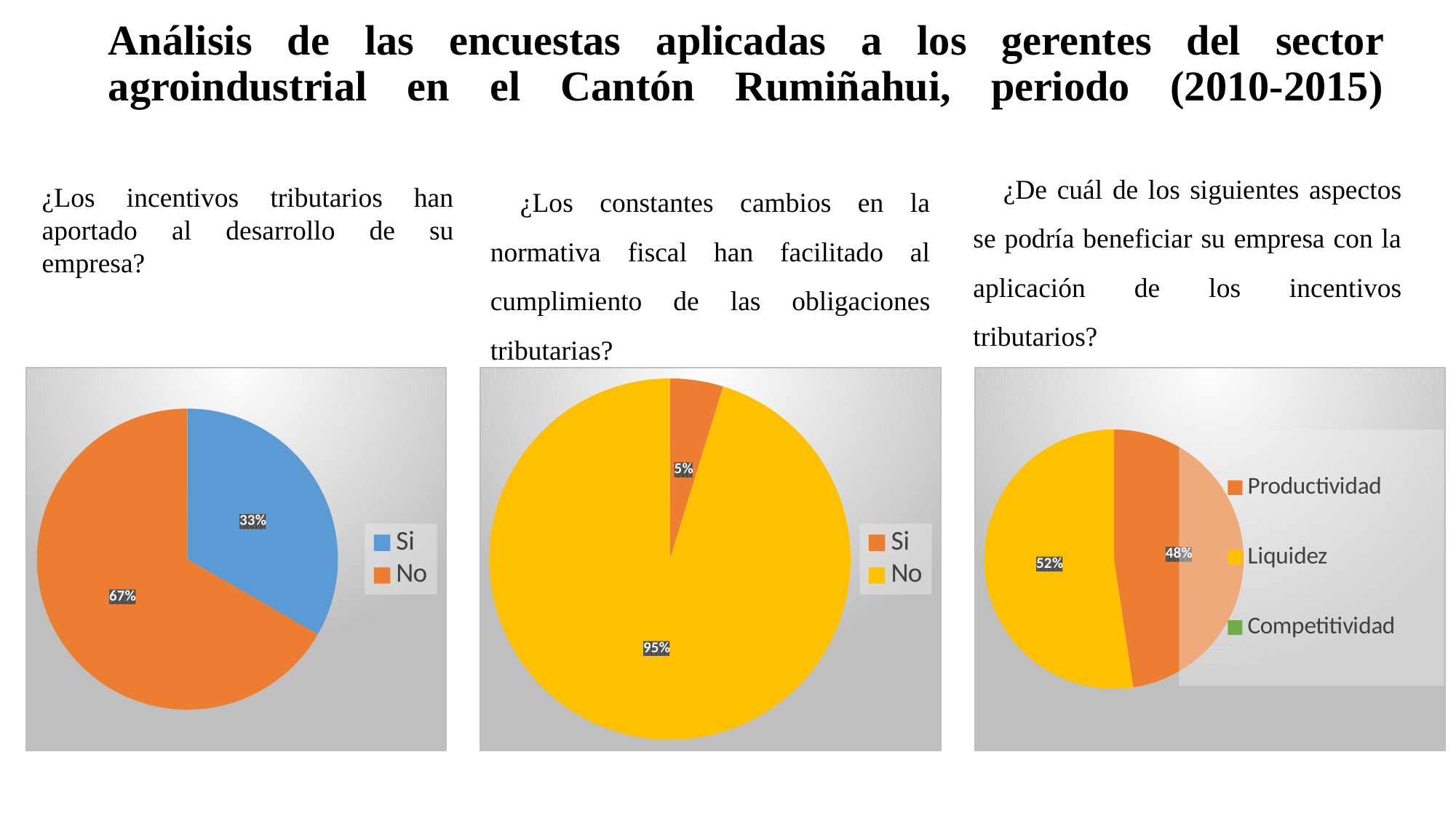
In the middle pie chart, what percentage of respondents answered "No"? 95% In the right pie chart, what percentage corresponds to "Productividad"? 48% In the left pie chart, what is the difference in percentage points between "No" and "Si"? 34 In the middle pie chart, what percentage of respondents answered "Si"? 5% In the middle pie chart, which response has the smaller share? Si In the left pie chart, which response has the larger share? No In the left pie chart, what percentage of respondents answered "No"? 67% In the middle pie chart, what colour represents the "No" response? Yellow In the right pie chart, what percentage corresponds to "Liquidez"? 52% In the right pie chart, how many entries does the legend list? 3 In the left pie chart, what percentage of respondents answered "Si"? 33% What type of chart is used for the three charts on the slide? Pie chart